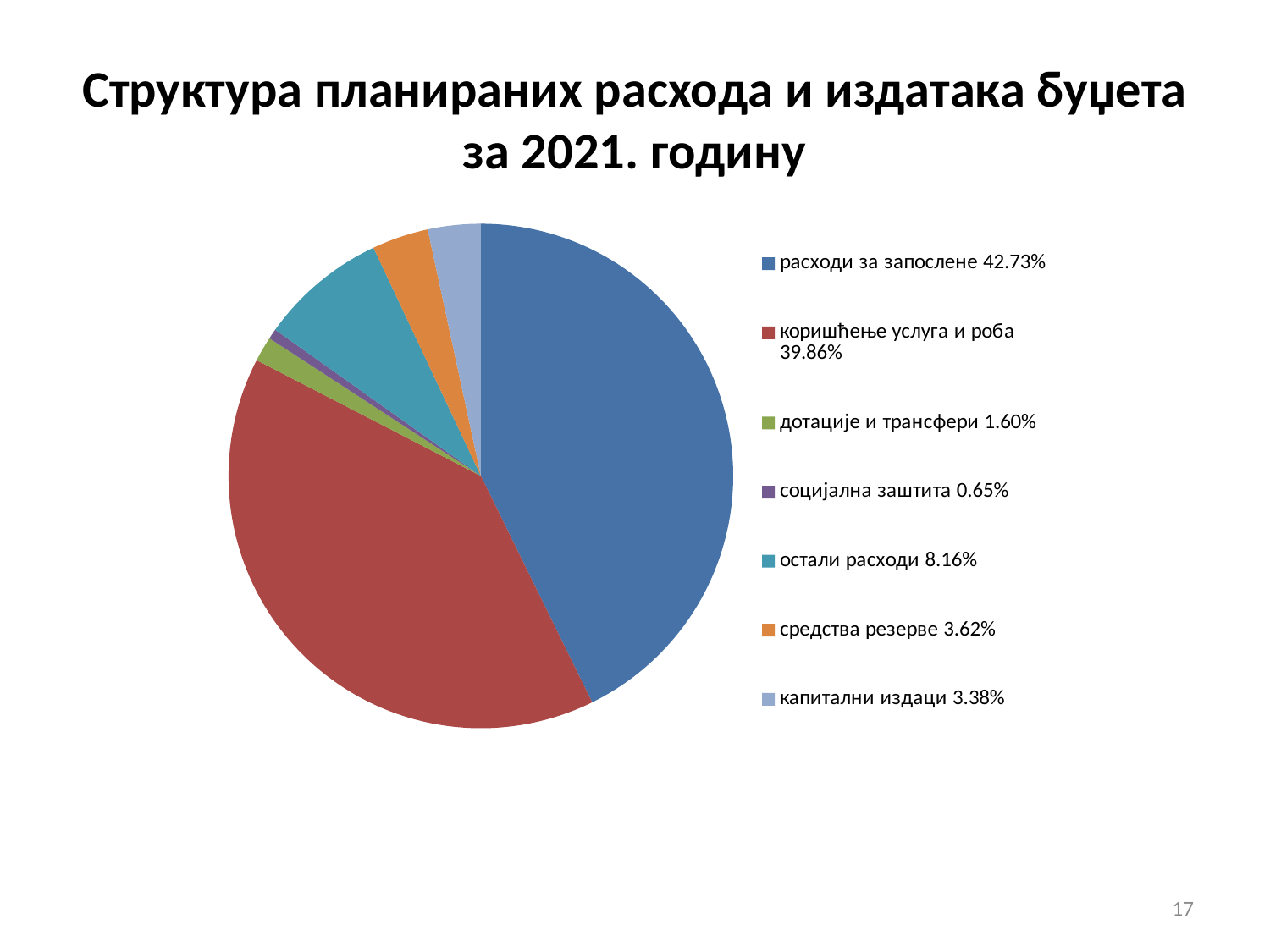
Which category has the smallest share of the pie? социјална заштита What percentage is shown for остали расходи? 8.16% What is the difference in percentage points between расходи за запослене and коришћење услуга и роба? 2.87% What type of chart is shown on the slide? pie chart Which category has the largest share of the pie? расходи за запослене What percentage is shown for коришћење услуга и роба? 39.86% What is the difference between остали расходи and средства резерве? 4.54% How many categories does the pie chart show? 7 What is the title of the chart on the slide? Структура планираних расхода и издатака буџета за 2021. годину Which is larger, средства резерве or капитални издаци? средства резерве What share does социјална заштита have in the pie chart? 0.65% What share of the budget is planned for расходи за запослене? 42.73%